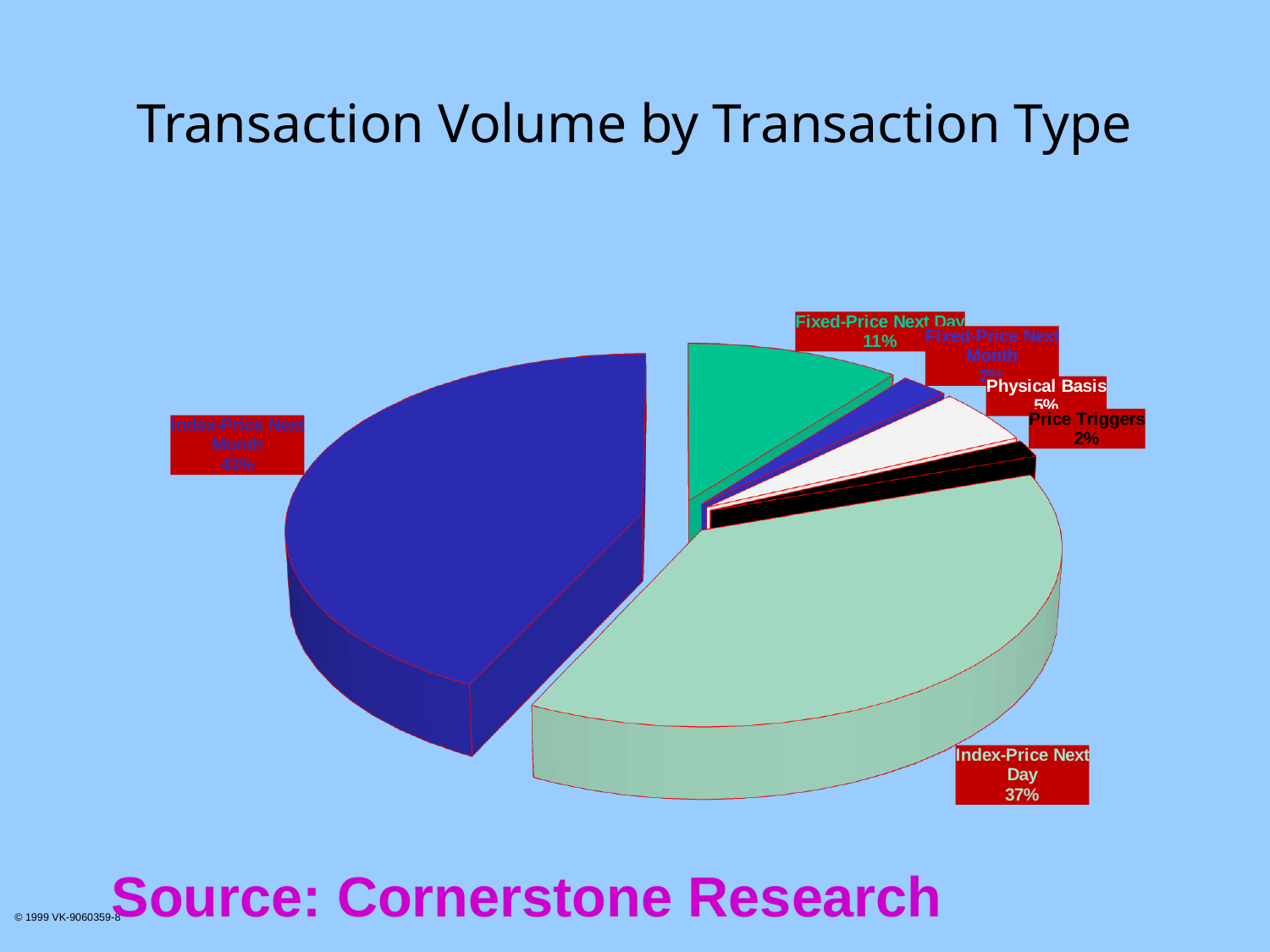
What is the title of the chart? Transaction Volume by Transaction Type What kind of chart is shown on the slide? Pie chart How many percentage points larger is the Fixed-Price Next Day share than the Price Triggers share? 9 percentage points What source is cited for the chart? Cornerstone Research What share of transaction volume is Index-Price Next Month? 43% How many percentage points larger is the Index-Price Next Month share than the Index-Price Next Day share? 6 percentage points What share of transaction volume is Index-Price Next Day? 37% What share of transaction volume is Fixed-Price Next Day? 11% How many transaction types are shown in the pie chart? 6 What share of transaction volume is Price Triggers? 2% Which transaction type has the largest share of transaction volume? Index-Price Next Month Which has a larger share of transaction volume, Fixed-Price Next Day or Physical Basis? Fixed-Price Next Day